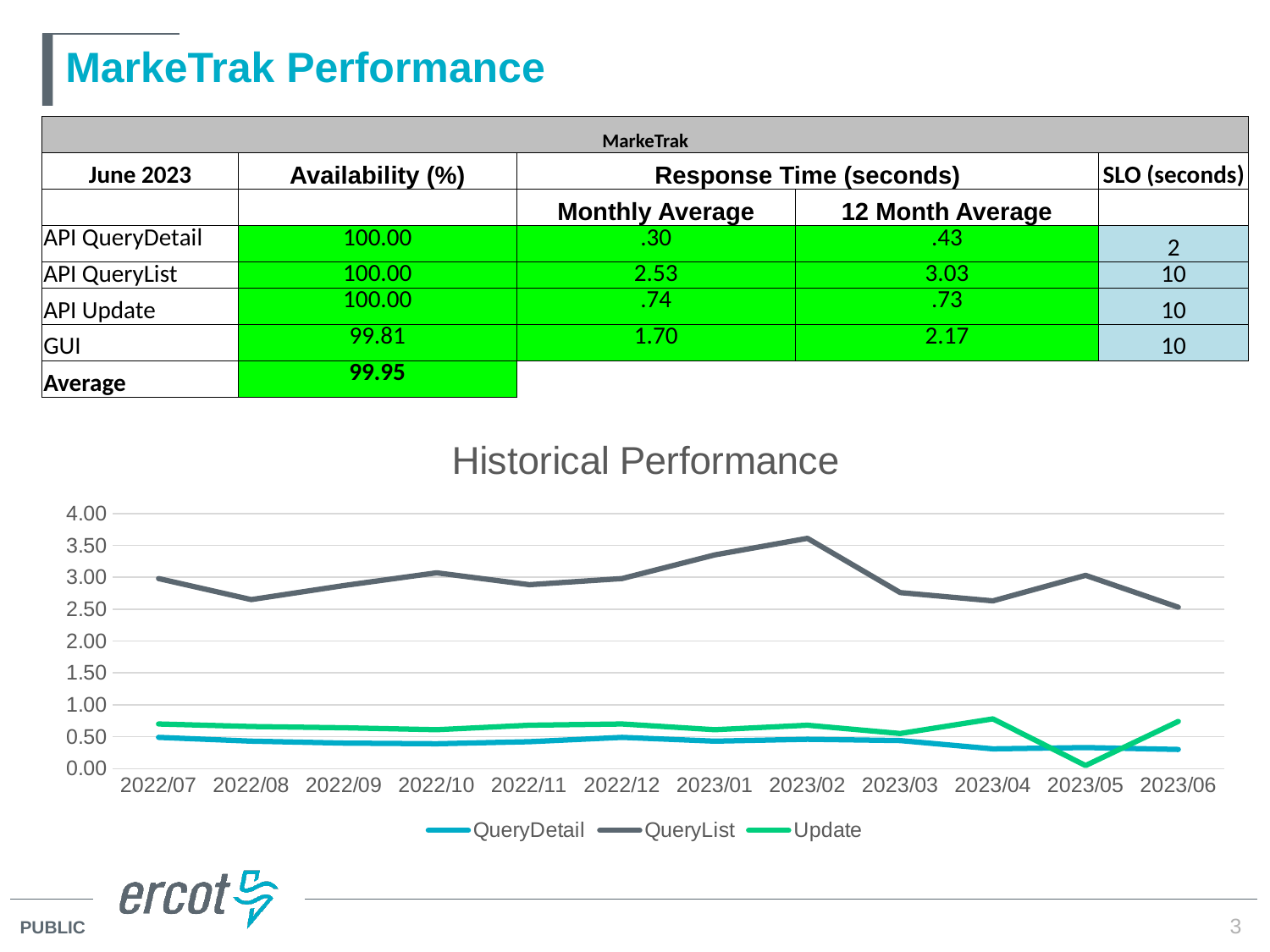
In the Historical Performance chart, is the QueryList value for 2023/02 greater or less than 3.00? greater In the Historical Performance chart, is the Update value for 2023/05 greater or less than 0.50? less In which month does the Update series reach its lowest point in the Historical Performance chart? 2023/05 In the Historical Performance chart, does the QueryList series rise or fall from 2023/02 to 2023/04? fall In the Historical Performance chart, is the Update value for 2023/04 greater or less than 0.50? greater How many months are plotted along the x axis of the Historical Performance chart? 12 In the Historical Performance chart, which series has the larger value at 2023/01, QueryList or Update? QueryList How many series does the legend of the Historical Performance chart list? 3 Which series in the Historical Performance chart has the highest values throughout the period? QueryList What type of chart is shown under the title 'Historical Performance'? line chart In which month does the QueryList series reach its highest point in the Historical Performance chart? 2023/02